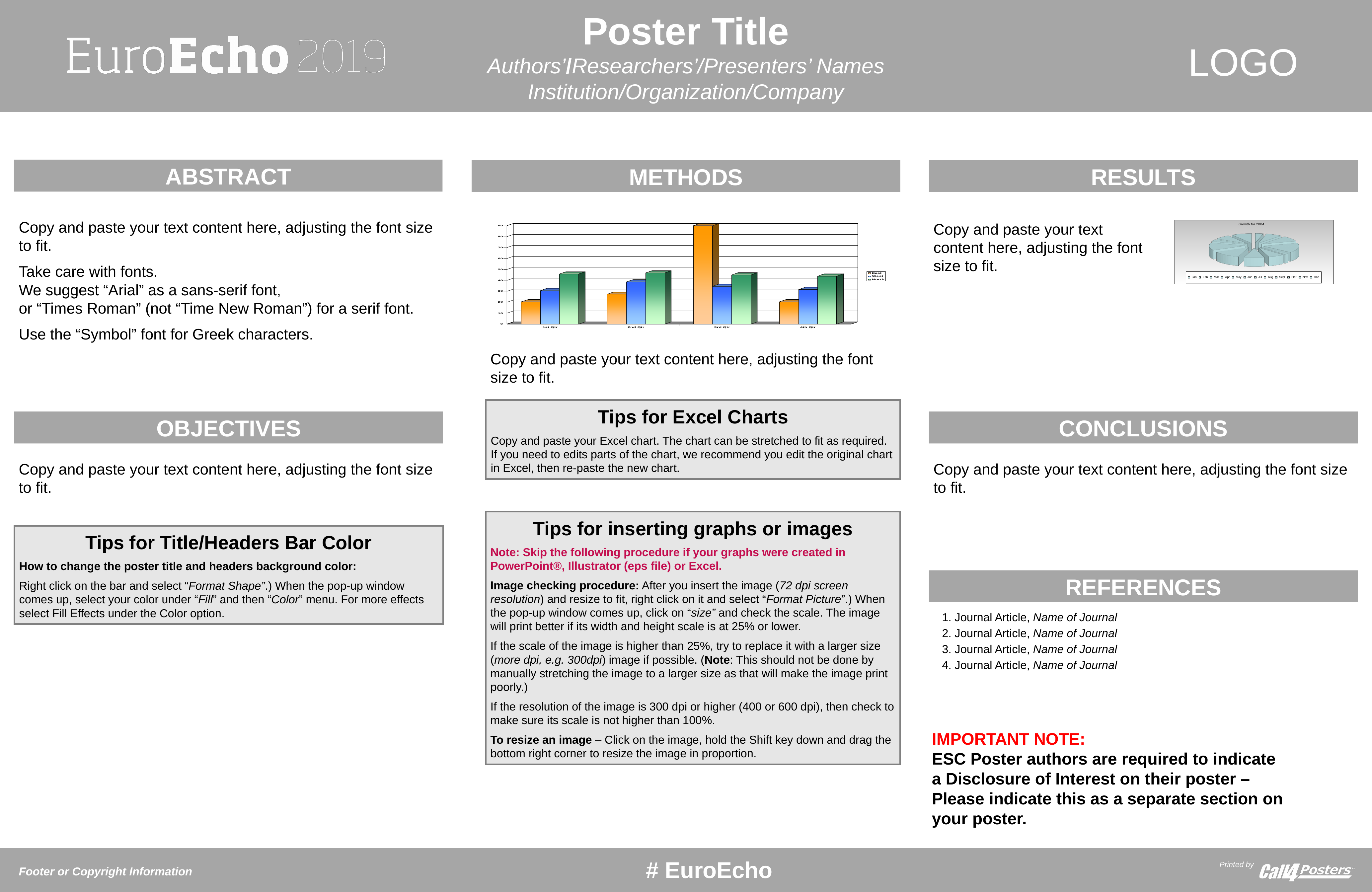
In the METHODS bar chart, how many quarter categories are shown on the x axis? 4 In the METHODS bar chart, in which quarter is the East series highest? 3rd Qtr In the METHODS bar chart, which is larger in 3rd Qtr, East or West? East What kind of chart is shown in the METHODS section? bar chart In the METHODS bar chart, which is larger in 1st Qtr, East or North? North What is the title of the pie chart in the RESULTS section? Growth for 2004 What kind of chart is shown in the RESULTS section? pie chart In the METHODS bar chart, is the value for East in 1st Qtr greater or less than 30? less In the METHODS bar chart, how many series does the legend list? 3 In the METHODS bar chart, what are the three legend entries? East, West, North In the METHODS bar chart, is the value for East in 3rd Qtr greater or less than 70? greater In the METHODS bar chart, is the value for North in 1st Qtr greater or less than 40? greater